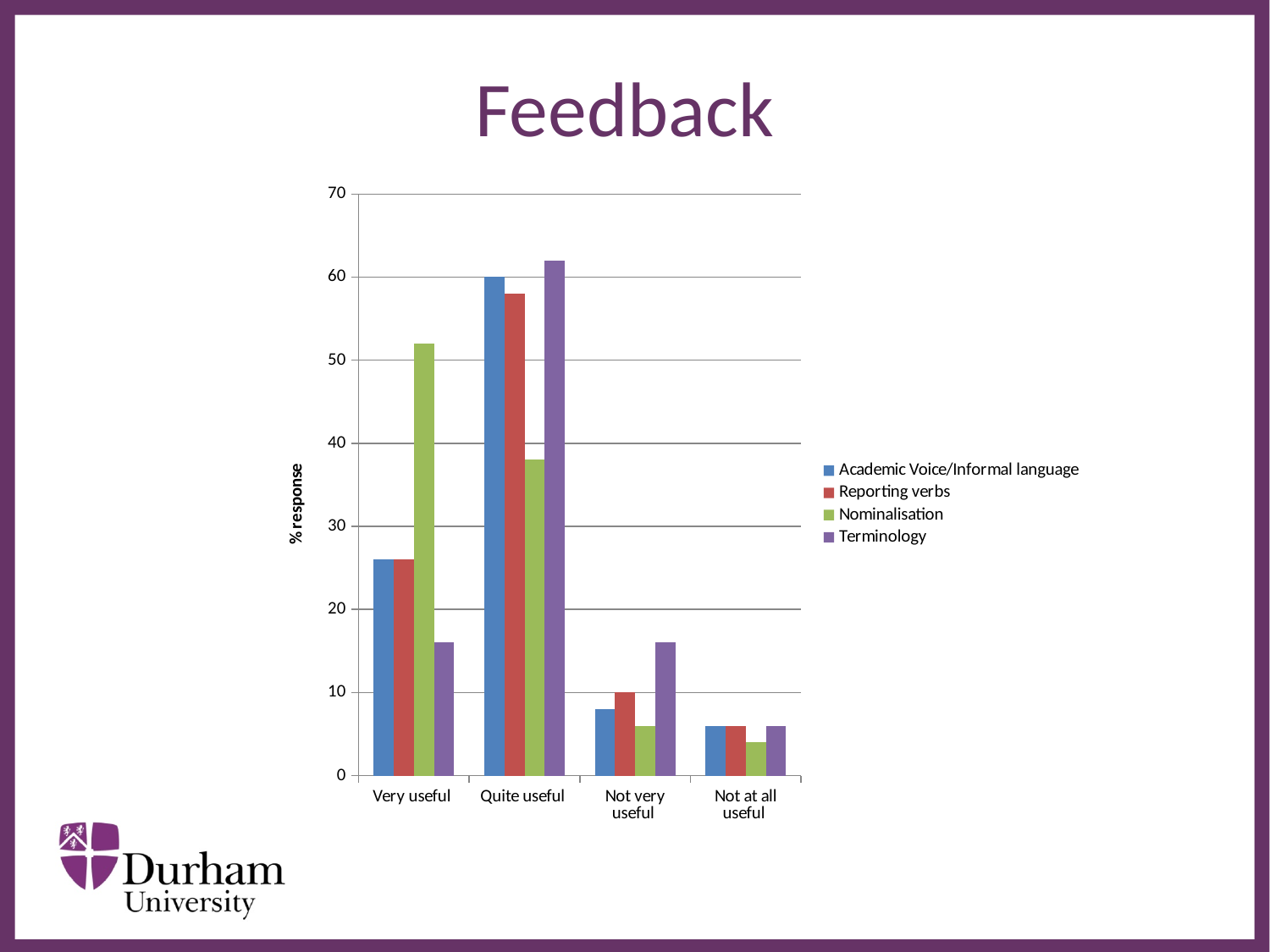
Which series has the lowest value in the Not at all useful category? Nominalisation How many series does the legend list? 4 What is the title of the chart? Feedback Is the value for Terminology in the Very useful category greater or less than 20? less What kind of chart is shown on the slide? bar chart Is the value for Nominalisation in the Very useful category greater or less than 50? greater Is the value for Academic Voice/Informal language in the Very useful category greater or less than 30? less How many categories are shown on the x axis? 4 Which series has the highest value in the Not very useful category? Terminology For Nominalisation, which category has the larger value: Very useful or Quite useful? Very useful Which series has the highest value in the Very useful category? Nominalisation What is the label on the vertical axis? % response